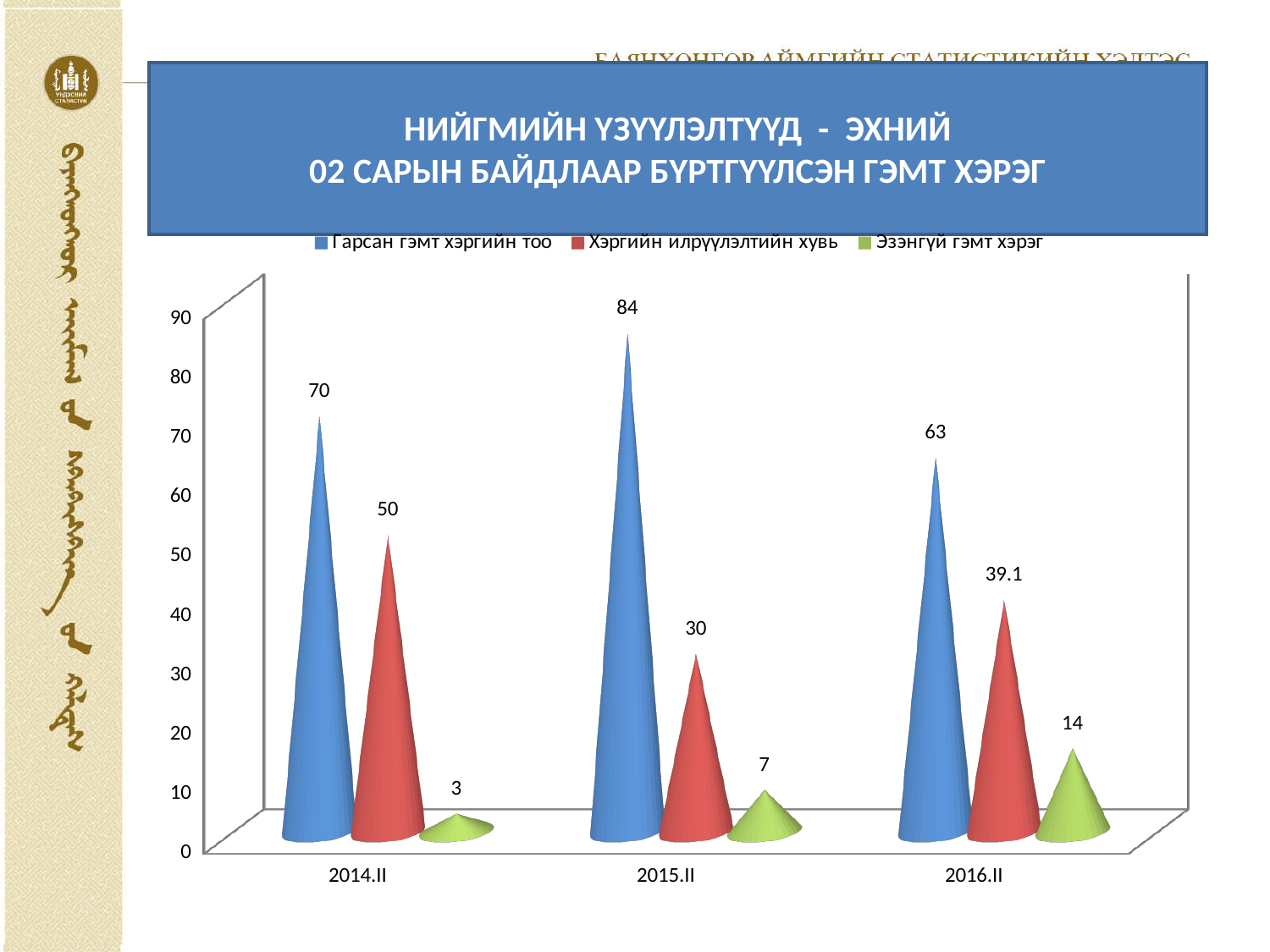
Which colour represents Хэргийн илрүүлэлтийн хувь in the legend? red Does Эзэнгүй гэмт хэрэг rise or fall from 2014.II to 2016.II? rise Which is larger: Эзэнгүй гэмт хэрэг in 2015.II or in 2016.II? 2016.II What is the difference between Гарсан гэмт хэргийн тоо in 2015.II and 2016.II? 21 What kind of chart is shown on the slide? bar chart What is the value of Хэргийн илрүүлэлтийн хувь for 2016.II? 39.1 What is the value of Гарсан гэмт хэргийн тоо for 2015.II? 84 How many series does the legend list? 3 How many periods are shown on the x axis? 3 In which period is Хэргийн илрүүлэлтийн хувь lowest? 2015.II What is the value of Эзэнгүй гэмт хэрэг for 2014.II? 3 In which period is Гарсан гэмт хэргийн тоо highest? 2015.II